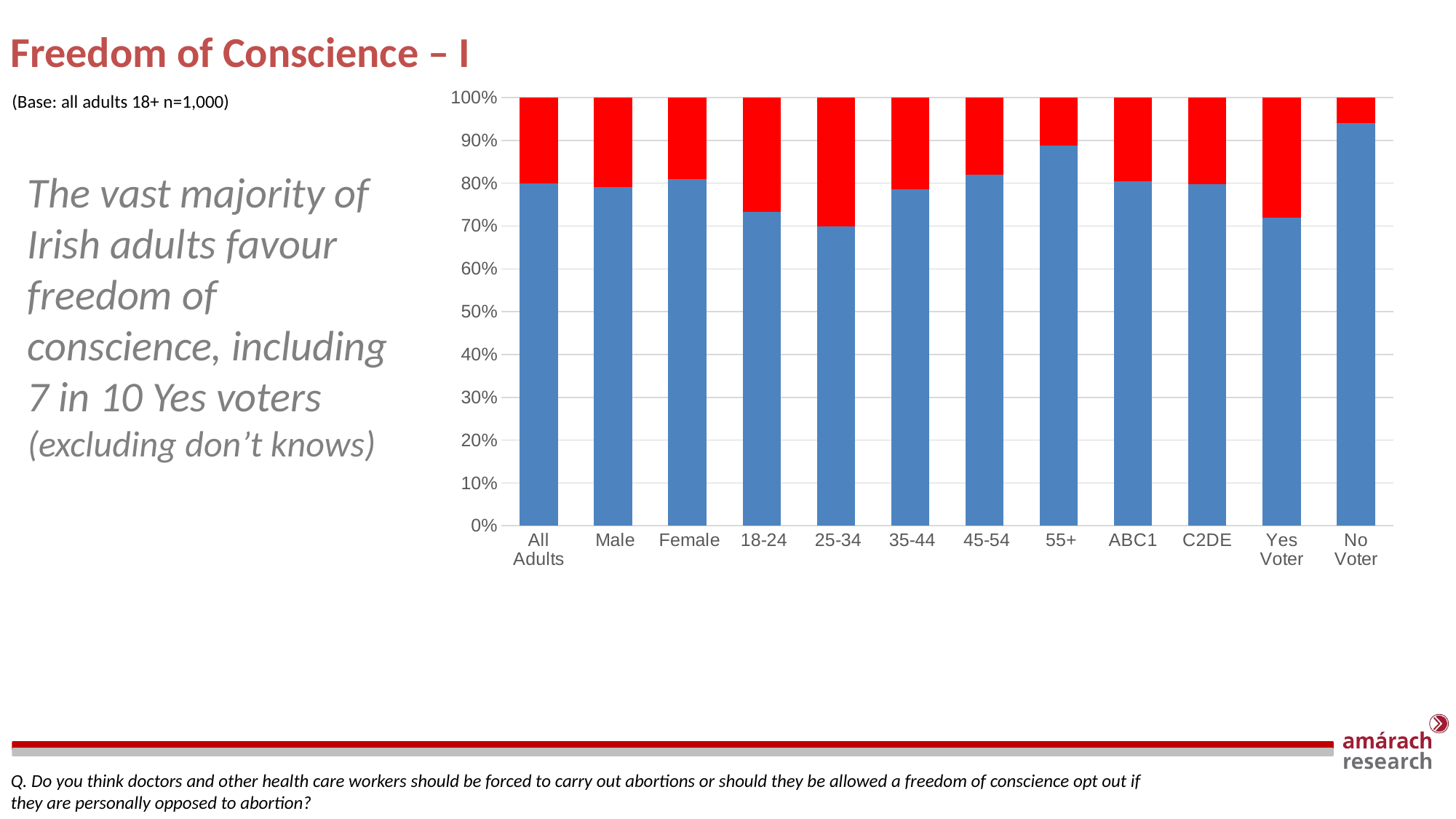
Is the blue segment for Yes Voter greater or less than 80%? less Is the blue segment for 55+ greater or less than 80%? greater Is the blue segment for No Voter greater or less than 90%? greater What does each stacked bar in the chart total? 100% Which category has the largest blue segment in the chart? No Voter How many categories are shown along the x axis of the chart? 12 Which category has the largest red segment in the chart? 25-34 What kind of chart is shown on the slide? Stacked bar chart Which has a larger blue segment, Yes Voter or No Voter? No Voter Which has a larger red segment, 18-24 or 55+? 18-24 What is the title of the slide containing the chart? Freedom of Conscience – I